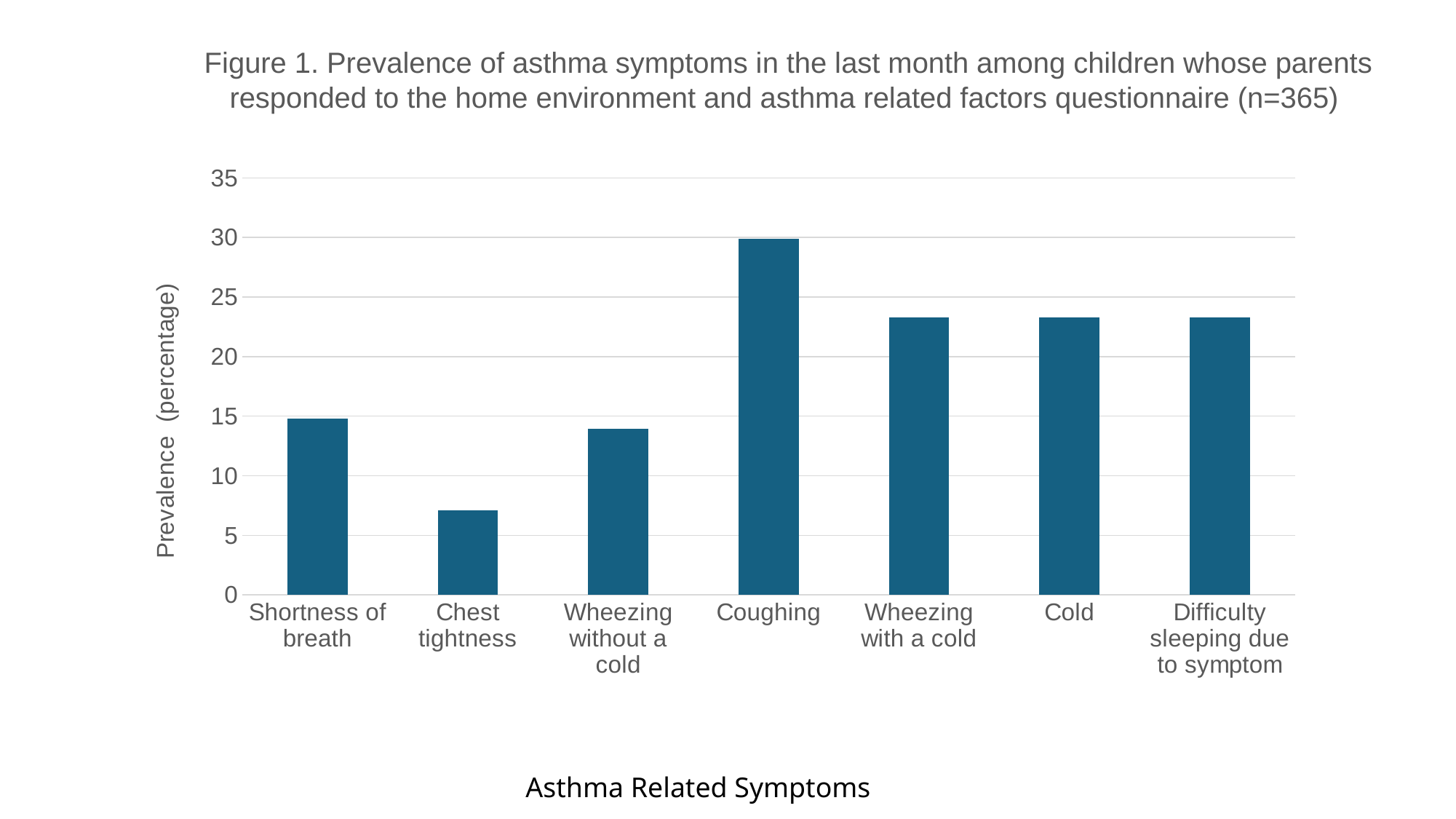
Which has a higher prevalence, Wheezing with a cold or Chest tightness? Wheezing with a cold Is the prevalence for Shortness of breath greater or less than 10? greater Is the prevalence for Chest tightness greater or less than 10? less Which symptom has the highest prevalence? Coughing Is the prevalence for Cold greater or less than 20? greater What kind of chart is shown on the slide? bar chart How many asthma related symptoms are plotted on the chart? 7 What is the label of the vertical axis? Prevalence (percentage) Which symptom has the lowest prevalence? Chest tightness What is the label of the horizontal axis? Asthma Related Symptoms